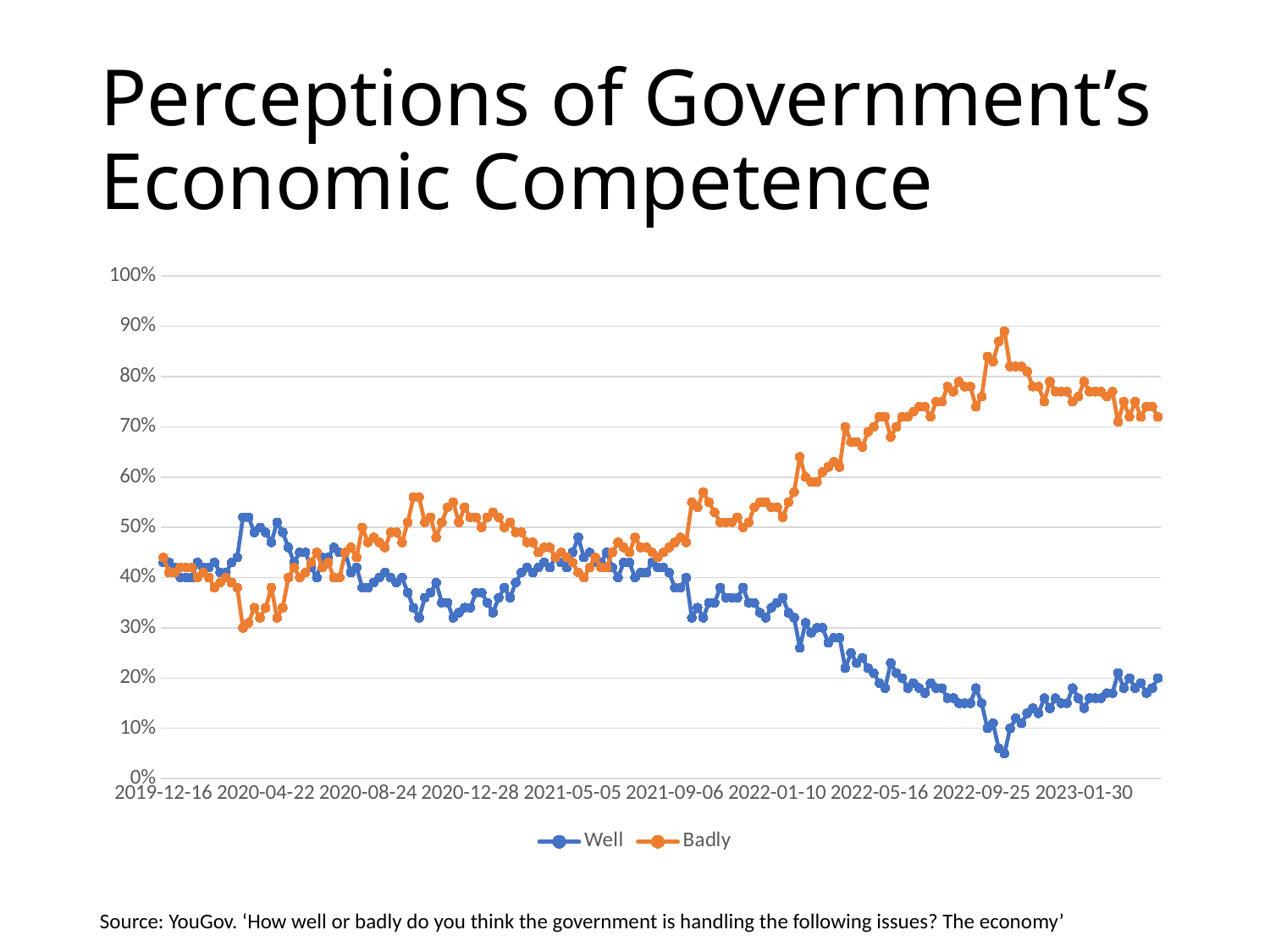
What are the two series named in the legend? Well and Badly How many series does the legend list? 2 Is the value for Well at 2022-05-16 greater or less than 30%? less Does the Well series rise or fall overall from 2019-12-16 to the end of the chart? fall At 2020-04-22, which series has the larger value, Well or Badly? Well Does the Badly series rise or fall overall from 2019-12-16 to the end of the chart? rise Which series reaches the highest value anywhere on the chart? Badly What kind of chart is shown on the slide? line chart What is the title of the chart on the slide? Perceptions of Government's Economic Competence Is the value for Badly at 2022-05-16 greater or less than 60%? greater Which series reaches the lowest value anywhere on the chart? Well At 2023-01-30, which series has the larger value, Well or Badly? Badly